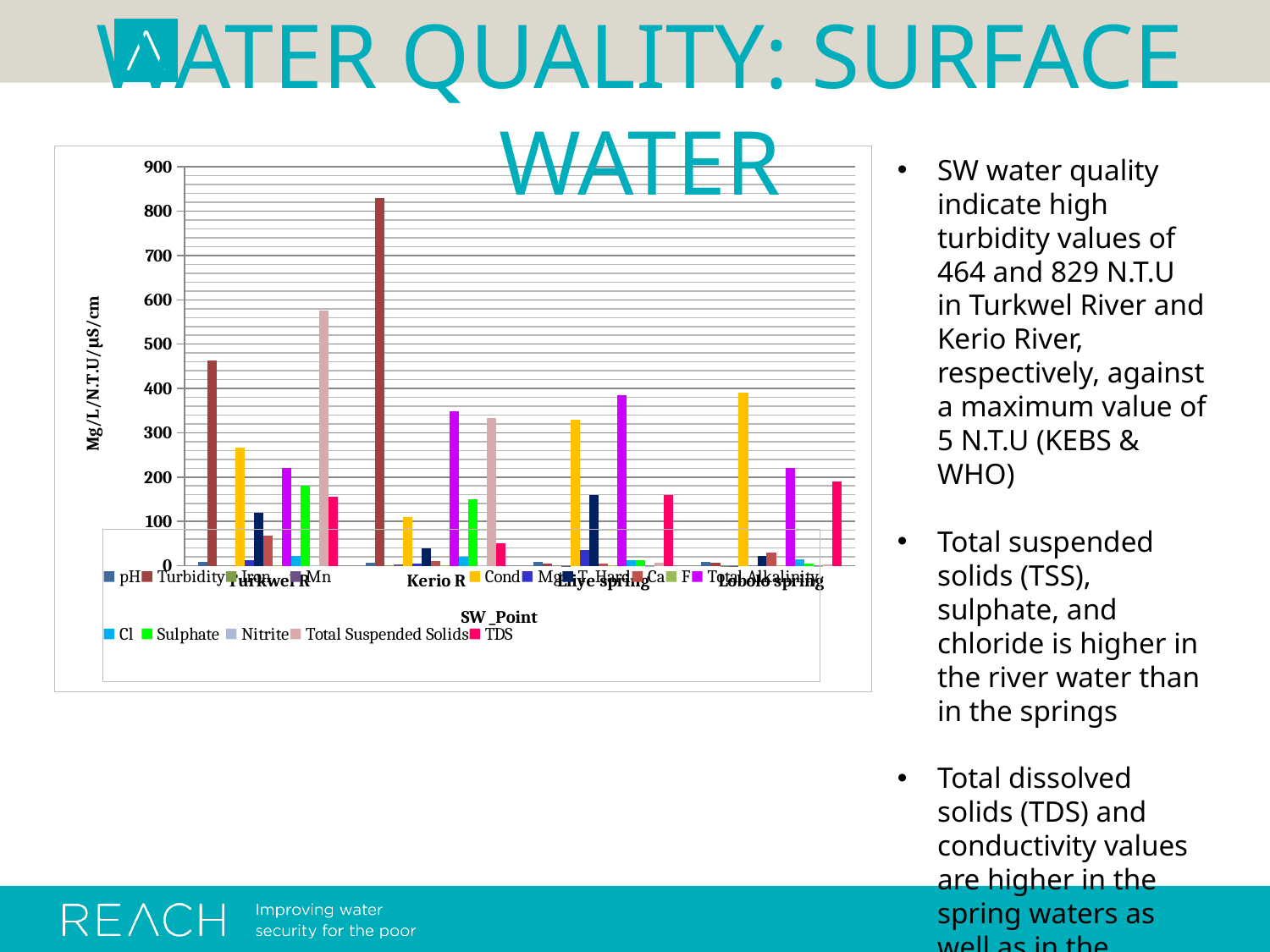
What is the title of the chart's x axis? SW_Point Is the TDS value for Turkwel R greater or less than 200? less Which sampling point has the highest Cond value? Lobolo spring Which is larger, the Total Suspended Solids value for Turkwel R or for Kerio R? Turkwel R Is the Turbidity value for Kerio R greater or less than 800? greater Is the Cond value for Lobolo spring greater or less than 300? greater Which sampling point has the highest Turbidity value? Kerio R How many sampling points (categories) are shown on the x axis of the chart? 4 How many series does the chart's legend list? 15 What kind of chart is shown on the slide? bar chart